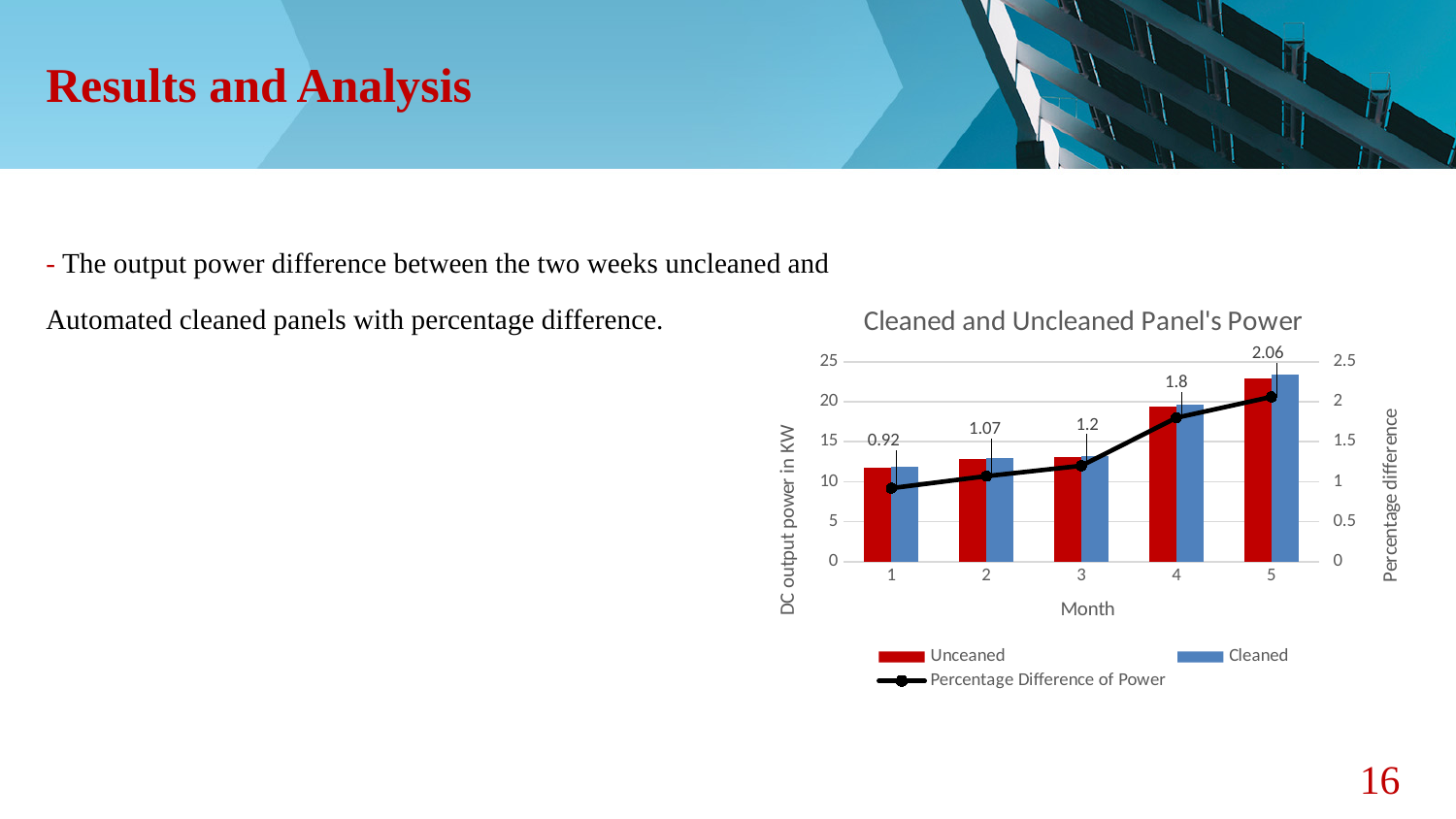
How many months are shown on the x axis? 5 What is the Percentage Difference of Power for month 5? 2.06 Does the Percentage Difference of Power rise or fall from month 1 to month 5? Rises Is the Uncleaned DC output power for month 5 greater or less than 20? greater What is the Percentage Difference of Power for month 3? 1.2 Is the Percentage Difference of Power larger in month 4 or month 2? Month 4 Is the Cleaned DC output power for month 1 greater or less than 15? less What is the difference between the Percentage Difference of Power in month 5 and month 1? 1.14 How many series does the legend list? 3 Which month has the highest Percentage Difference of Power? 5 What is the Percentage Difference of Power for month 1? 0.92 Which month has the lowest Percentage Difference of Power? 1